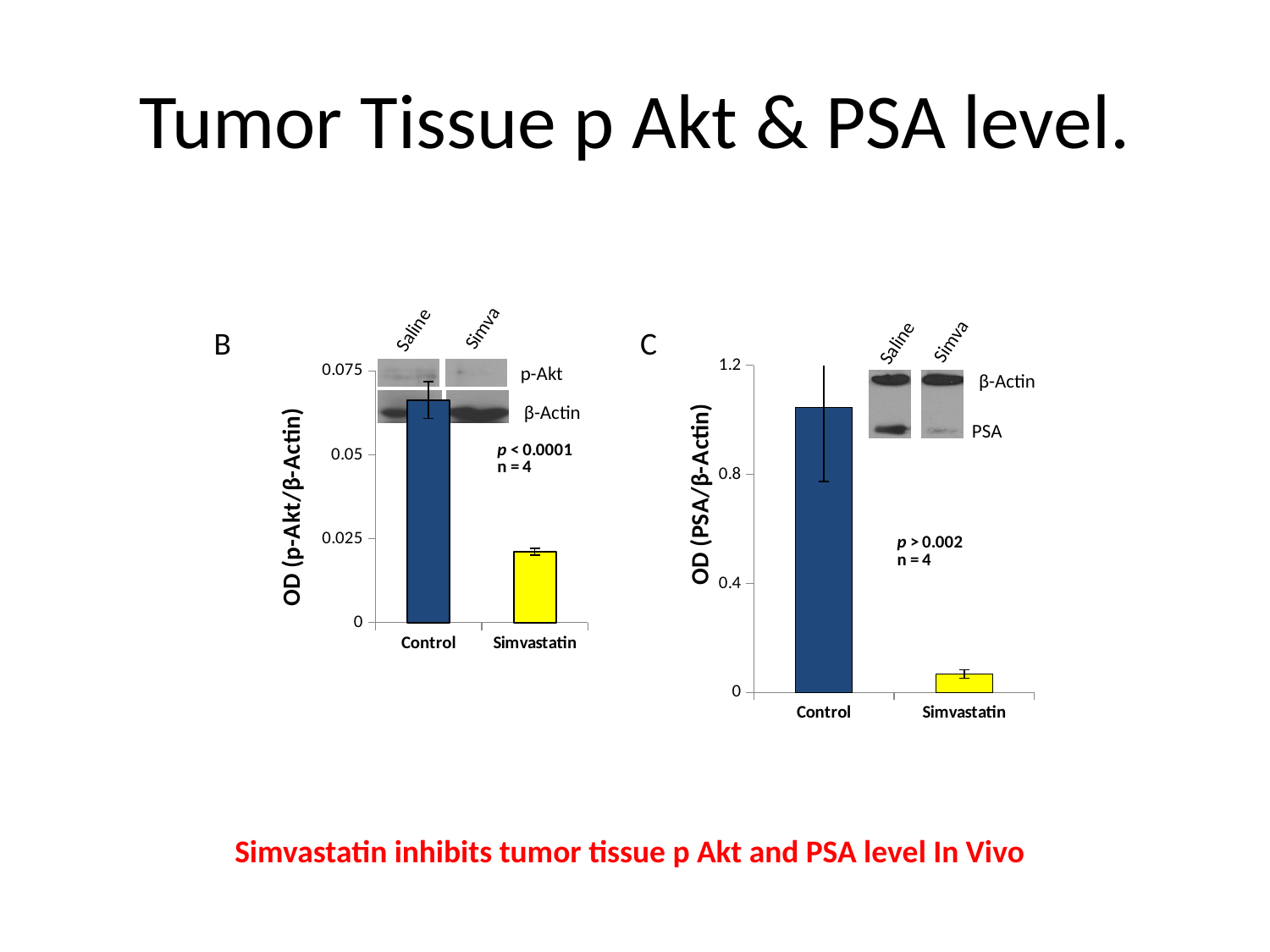
What p-value is stated on chart B (left)? p < 0.0001 In chart C (right), which category has the higher bar? Control In chart B (left), which category has the lowest bar? Simvastatin What kind of chart is chart C (right)? bar chart In chart B (left), is the value for Control greater or less than 0.05? greater In chart B (left), is the value for Simvastatin greater or less than 0.025? less How many categories are shown on the x axis of chart B (left)? 2 In chart B (left), which category has the higher bar? Control In chart C (right), is the value for Simvastatin greater or less than 0.4? less What is the y-axis title of chart C (right)? OD (PSA/β-Actin) In chart C (right), is the bar for Control larger or smaller than the bar for Simvastatin? larger